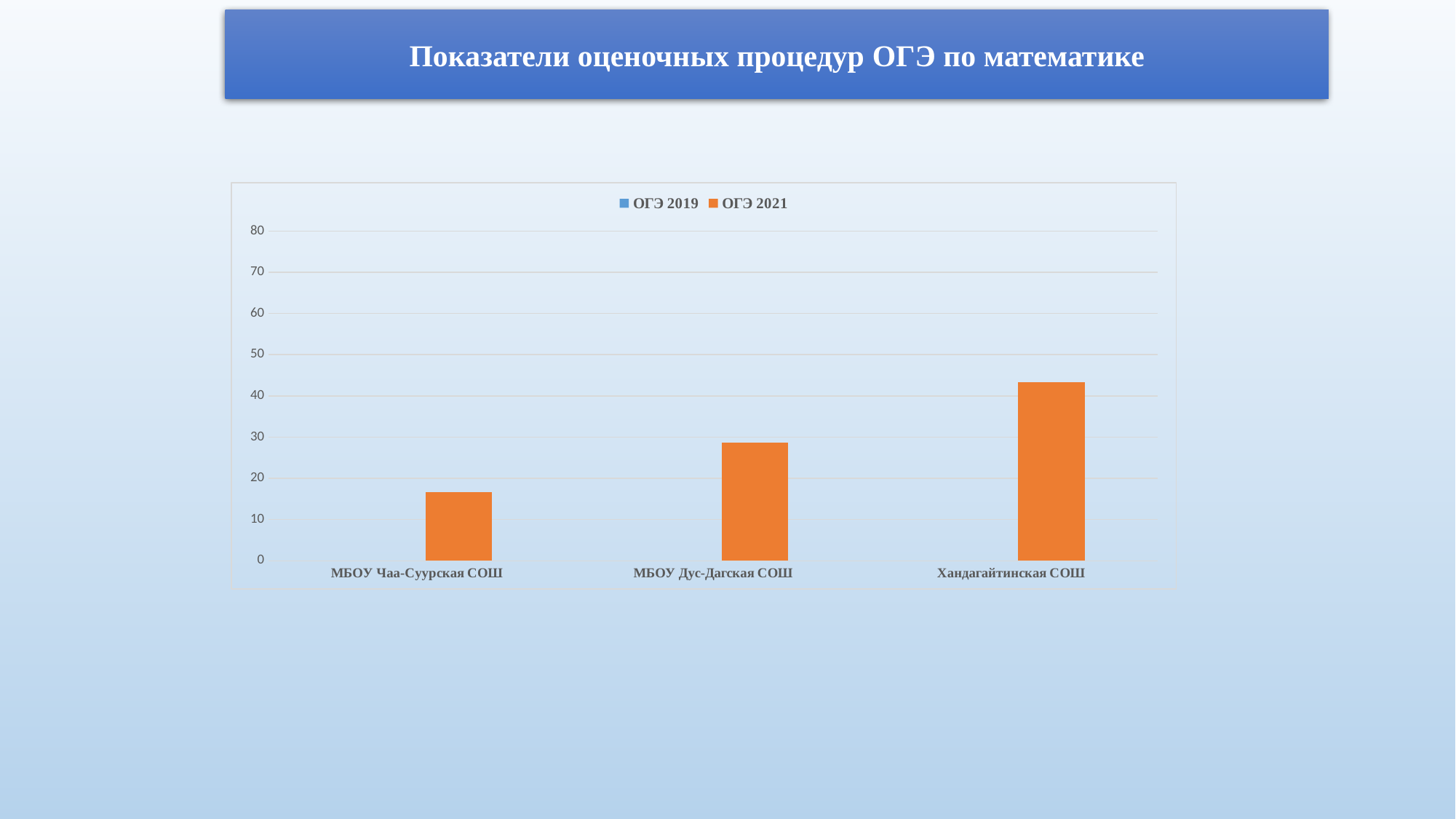
Do the ОГЭ 2021 values rise or fall from left to right across the schools on the x axis? rise Which has a larger ОГЭ 2021 value: МБОУ Дус-Дагская СОШ or МБОУ Чаа-Суурская СОШ? МБОУ Дус-Дагская СОШ How many series does the chart legend list? 2 What kind of chart is shown on the slide? bar chart What colour are the ОГЭ 2021 bars in the chart? orange What is the title of the slide containing the chart? Показатели оценочных процедур ОГЭ по математике Which school has the lowest ОГЭ 2021 value in the chart? МБОУ Чаа-Суурская СОШ How many schools (categories) are shown on the x axis of the chart? 3 Is the ОГЭ 2021 value for МБОУ Дус-Дагская СОШ greater or less than 30? less Is the ОГЭ 2021 value for Хандагайтинская СОШ greater or less than 40? greater Which school has the highest ОГЭ 2021 value in the chart? Хандагайтинская СОШ Is the ОГЭ 2021 value for МБОУ Чаа-Суурская СОШ greater or less than 20? less